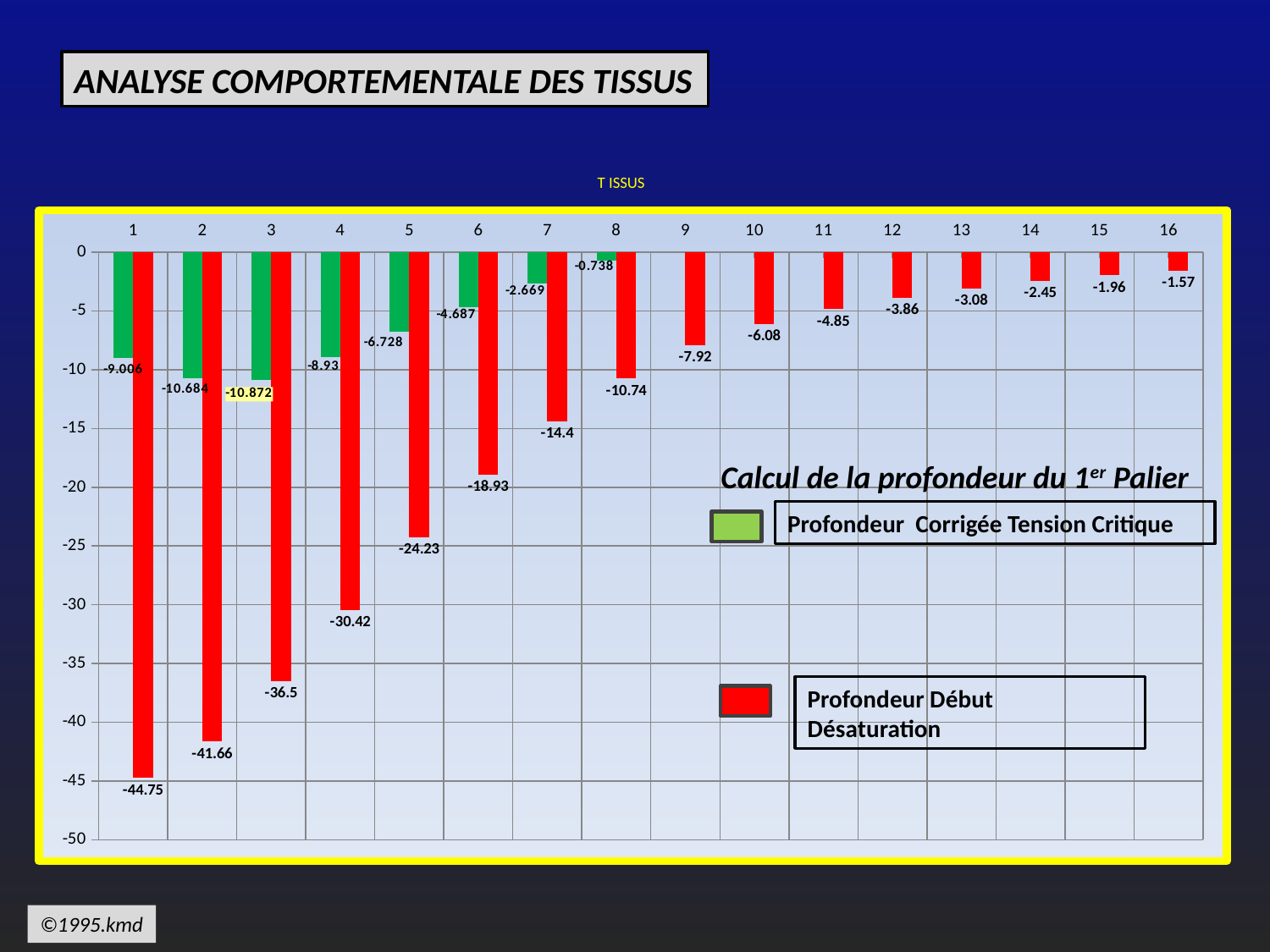
Do the 'Profondeur Début Désaturation' values become less negative or more negative as the tissue number increases from 1 to 16? Less negative What is the difference between the 'Profondeur Début Désaturation' values for tissue 1 and tissue 2? 3.09 How many series does the legend list? 2 How many tissue categories are shown on the x axis? 16 What is the value of the green 'Profondeur Corrigée Tension Critique' bar for tissue 8? -0.738 What kind of chart is shown on the slide? Bar chart What is the value of the red 'Profondeur Début Désaturation' bar for tissue 1? -44.75 Which tissue has the lowest (most negative) 'Profondeur Début Désaturation' value? 1 What is the value of the red 'Profondeur Début Désaturation' bar for tissue 16? -1.57 Which is more negative: the 'Profondeur Début Désaturation' value for tissue 5 or for tissue 6? Tissue 5 Which tissue has the most negative 'Profondeur Corrigée Tension Critique' value? 3 What is the value of the green 'Profondeur Corrigée Tension Critique' bar for tissue 3? -10.872